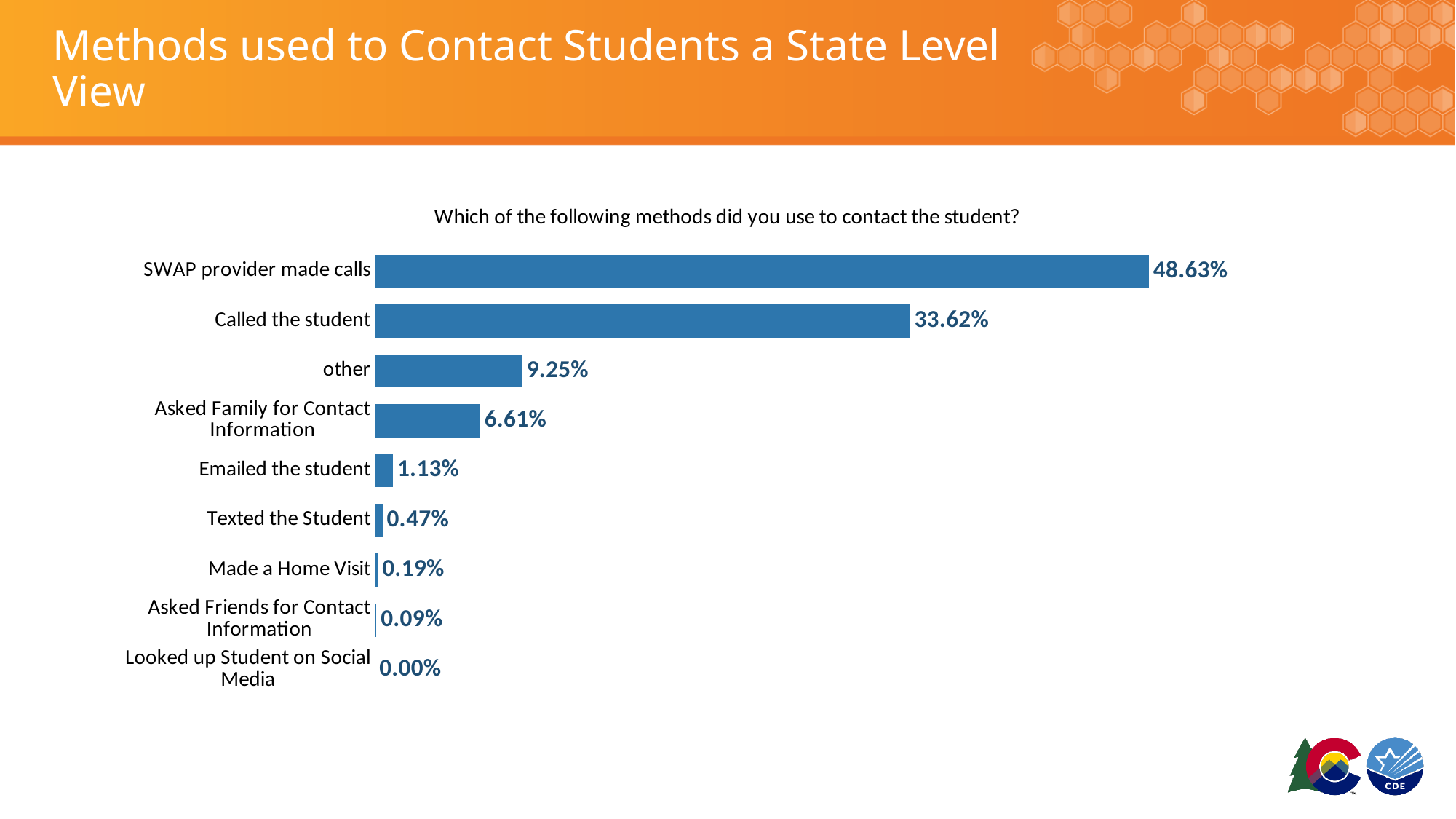
What is the value for "Texted the Student"? 0.47% What type of chart is shown on the slide? Bar chart What percentage is shown for "Asked Family for Contact Information"? 6.61% What is the difference between "SWAP provider made calls" and "Called the student"? 15.01% What percentage is shown for "SWAP provider made calls"? 48.63% What is the difference between "Emailed the student" and "Texted the Student"? 0.66% Which contact method has the highest percentage? SWAP provider made calls What is the title of the chart? Which of the following methods did you use to contact the student? Which is larger, "other" or "Emailed the student"? other How many contact methods are listed in the chart? 9 Which contact method has the lowest percentage? Looked up Student on Social Media What is the value for "Called the student"? 33.62%